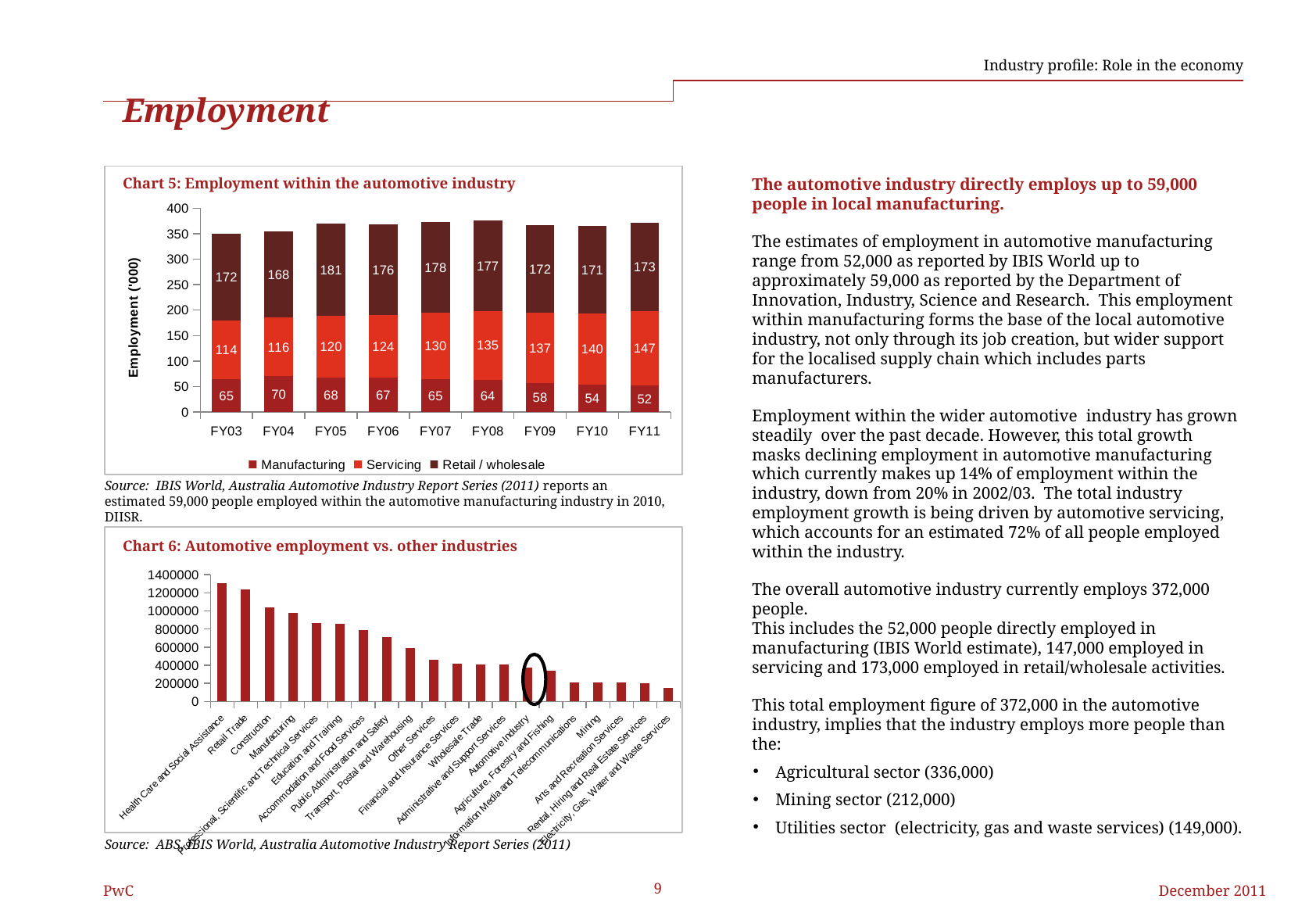
In Chart 6, which industry has the lowest employment? Electricity, Gas, Water and Waste Services In Chart 5, what is the difference between the Servicing values for FY11 and FY03? 33 In Chart 5, which fiscal year has the lowest Manufacturing value? FY11 In Chart 6, which industry has the highest employment? Health Care and Social Assistance In Chart 5, what is the Manufacturing value for FY04? 70 In Chart 5, what is the Servicing value for FY11? 147 What kind of chart is Chart 6? bar chart In Chart 5, which fiscal year has the highest Retail / wholesale value? FY05 In Chart 5, does the Servicing value rise or fall from FY03 to FY11? rise In Chart 5, how many series does the legend list? 3 In Chart 5, what is the total of the stacked bar for FY11? 372 In Chart 6, is the value for Mining greater or less than 400000? less